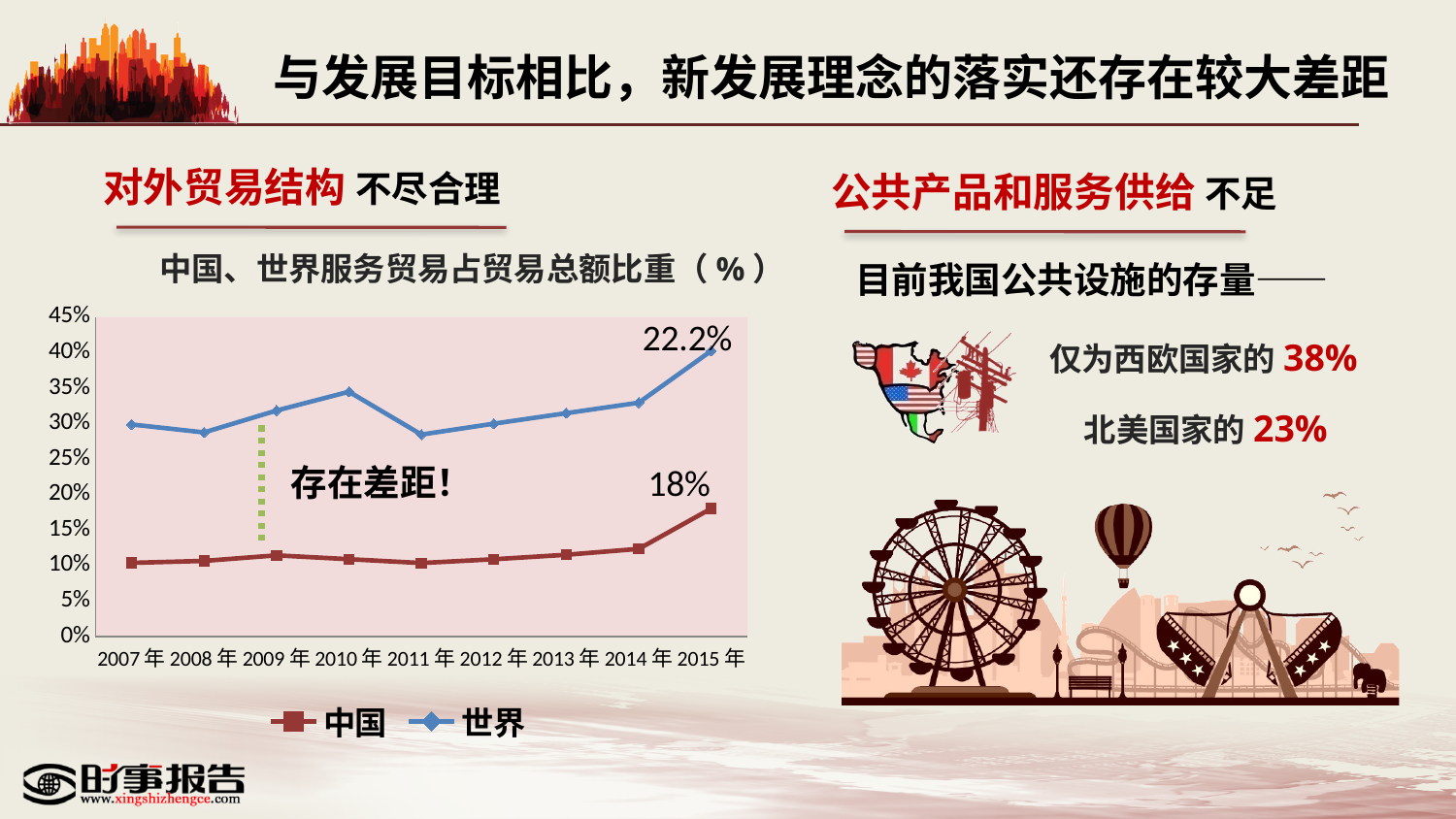
How many years are shown on the x axis of the chart? 9 Is the value for 世界 in 2011年 greater or less than 30%? less Does the 中国 series rise or fall overall from 2007年 to 2015年? rise What is the title of the chart? 中国、世界服务贸易占贸易总额比重（%） In which year does the 世界 series reach its highest value? 2015年 Is the value for 世界 in 2010年 greater or less than 30%? greater What is the value for 中国 in 2015年? 18% Which series has the higher value in 2015年, 中国 or 世界? 世界 How many series does the chart legend list? 2 Is the value for 中国 in 2007年 greater or less than 15%? less What is the value labelled for 世界 in 2015年? 22.2% What kind of chart is shown on the slide? line chart